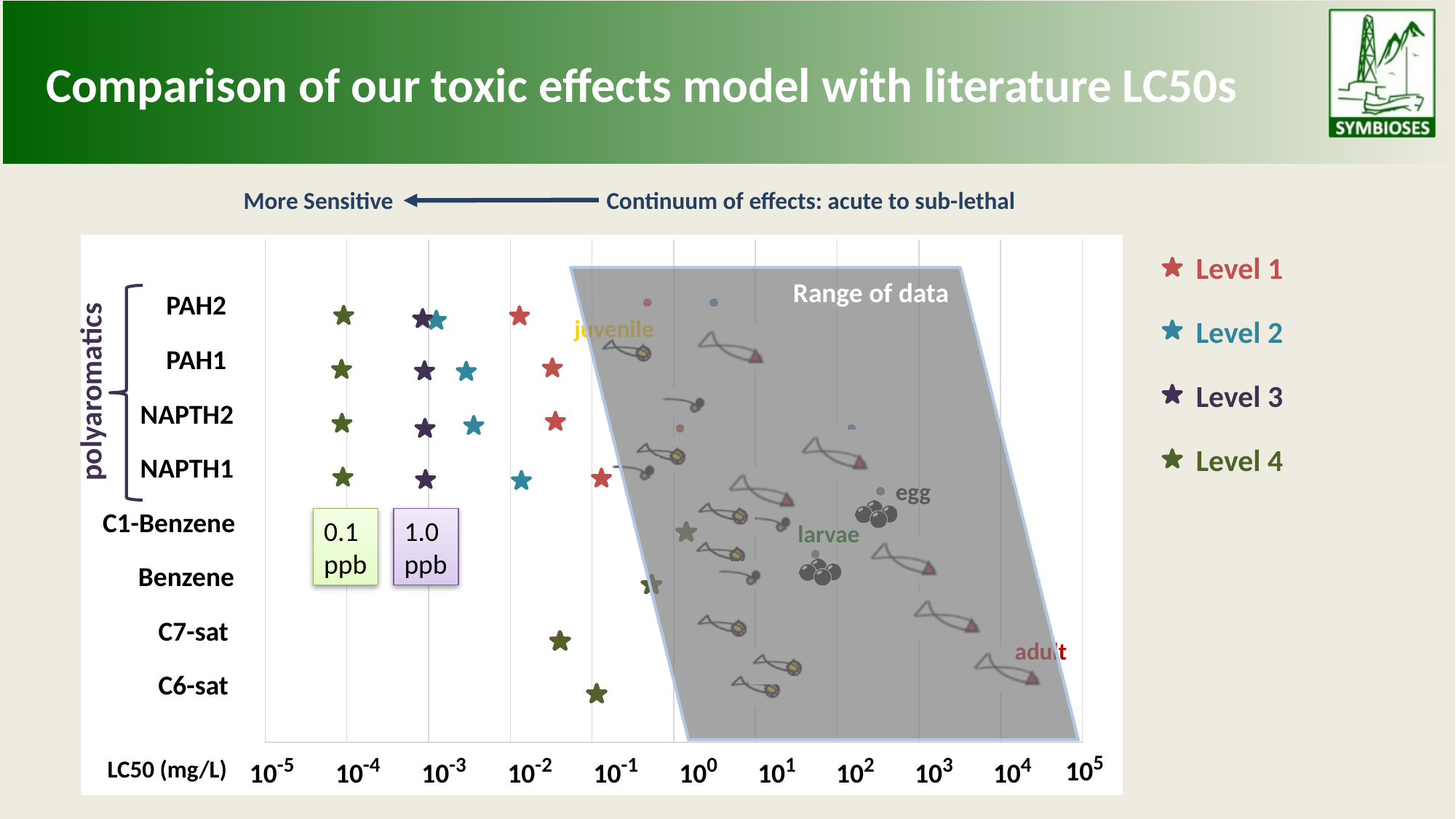
Is the Level 1 value for PAH1 greater or less than 10^-2? greater How many series does the legend list? 4 What label is written inside the grey shaded region of the chart? Range of data Is the Level 4 value for Benzene greater or less than 10^0? less Is the Level 4 value for C7-sat greater or less than 10^-1? less Which has the larger Level 1 value, NAPTH1 or PAH2? NAPTH1 Which has the larger Level 4 value, C6-sat or C7-sat? C6-sat What kind of chart is shown on the slide? scatter chart How many compound categories are listed on the y axis of the chart? 8 Among the Level 1 points, which category has the highest LC50 value? NAPTH1 What is the label of the x axis of the chart? LC50 (mg/L)